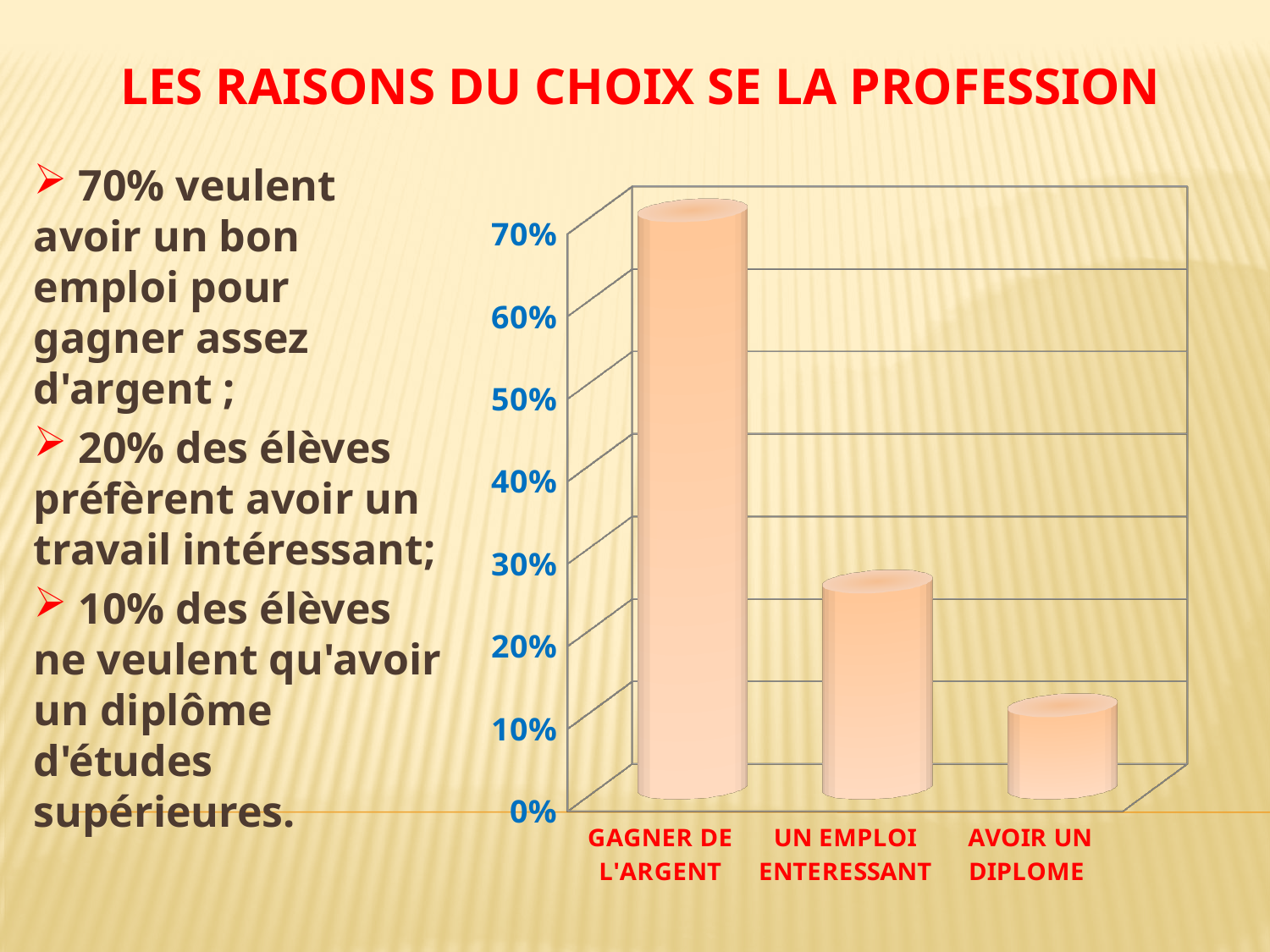
How many categories are shown on the x axis of the chart? 3 Is the value for AVOIR UN DIPLOME greater or less than 20%? less What kind of chart is shown on the slide? bar chart What is the title of the slide containing the chart? LES RAISONS DU CHOIX SE LA PROFESSION Is the value for UN EMPLOI ENTERESSANT greater or less than 40%? less What is the highest value shown on the chart's vertical axis? 70% Do the bar values rise or fall from left to right along the x axis? fall What is the value for GAGNER DE L'ARGENT? 70% Is the value for UN EMPLOI ENTERESSANT greater or less than 20%? greater Which category has the highest bar? GAGNER DE L'ARGENT Which category has the lowest bar? AVOIR UN DIPLOME Which is larger, the value for UN EMPLOI ENTERESSANT or the value for AVOIR UN DIPLOME? UN EMPLOI ENTERESSANT